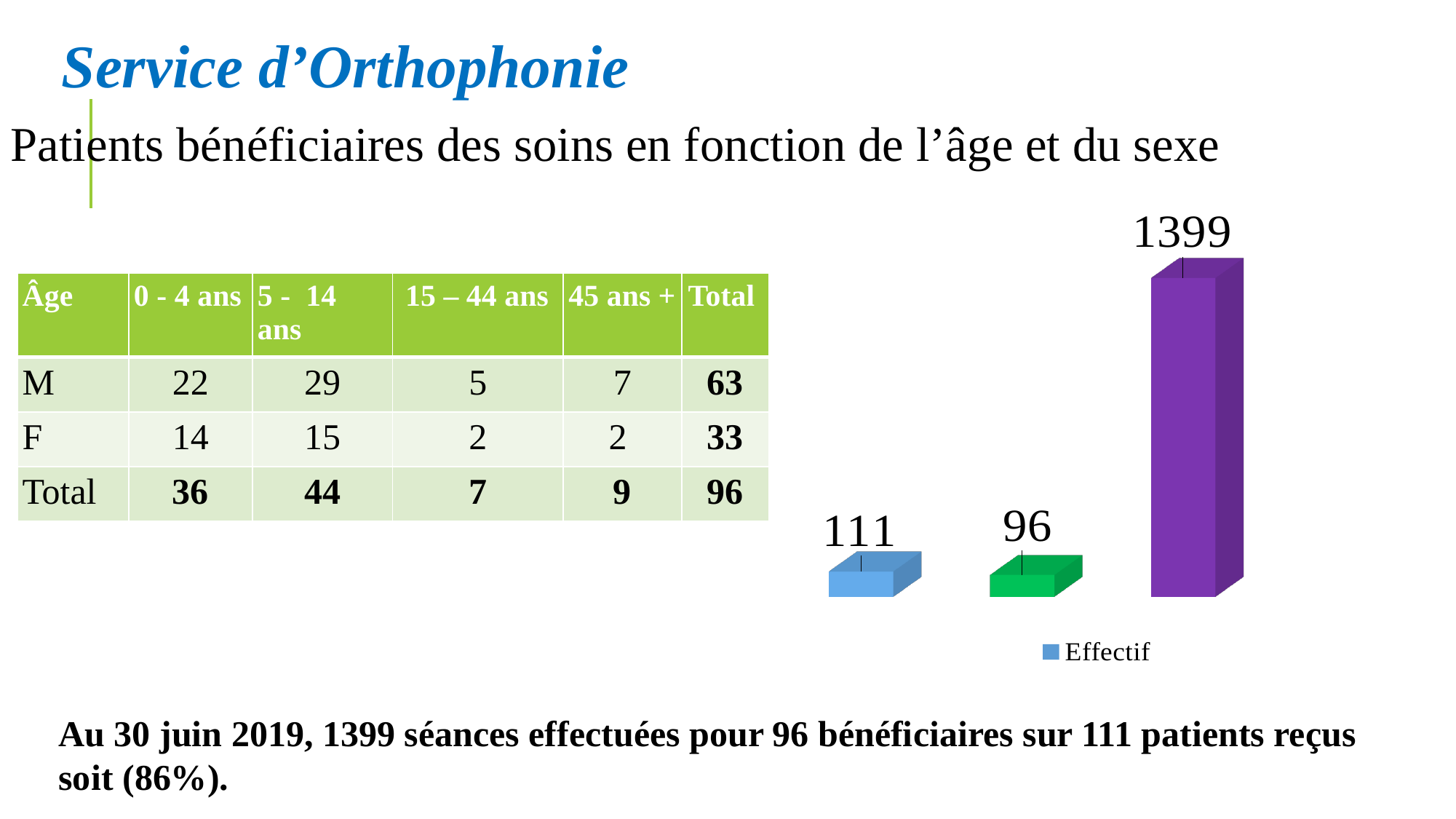
What is the value of the tallest (purple) bar in the chart? 1399 How many bars does the chart on the right of the slide show? 3 Which bar in the chart has the lowest value? the green bar in the middle (96) Which bar in the chart has the highest value? the purple bar on the right (1399) Which is larger in the chart, the blue bar or the green bar? the blue bar (111) What is the value of the green bar in the middle of the chart? 96 What is the difference between the blue bar (111) and the green bar (96) in the chart? 15 What kind of chart is shown on the right of the slide? bar chart What is the value of the blue bar on the left of the chart? 111 What is the difference between the purple bar (1399) and the blue bar (111) in the chart? 1288 How many series does the legend of the chart list? 1 What is the name of the series shown in the chart legend? Effectif